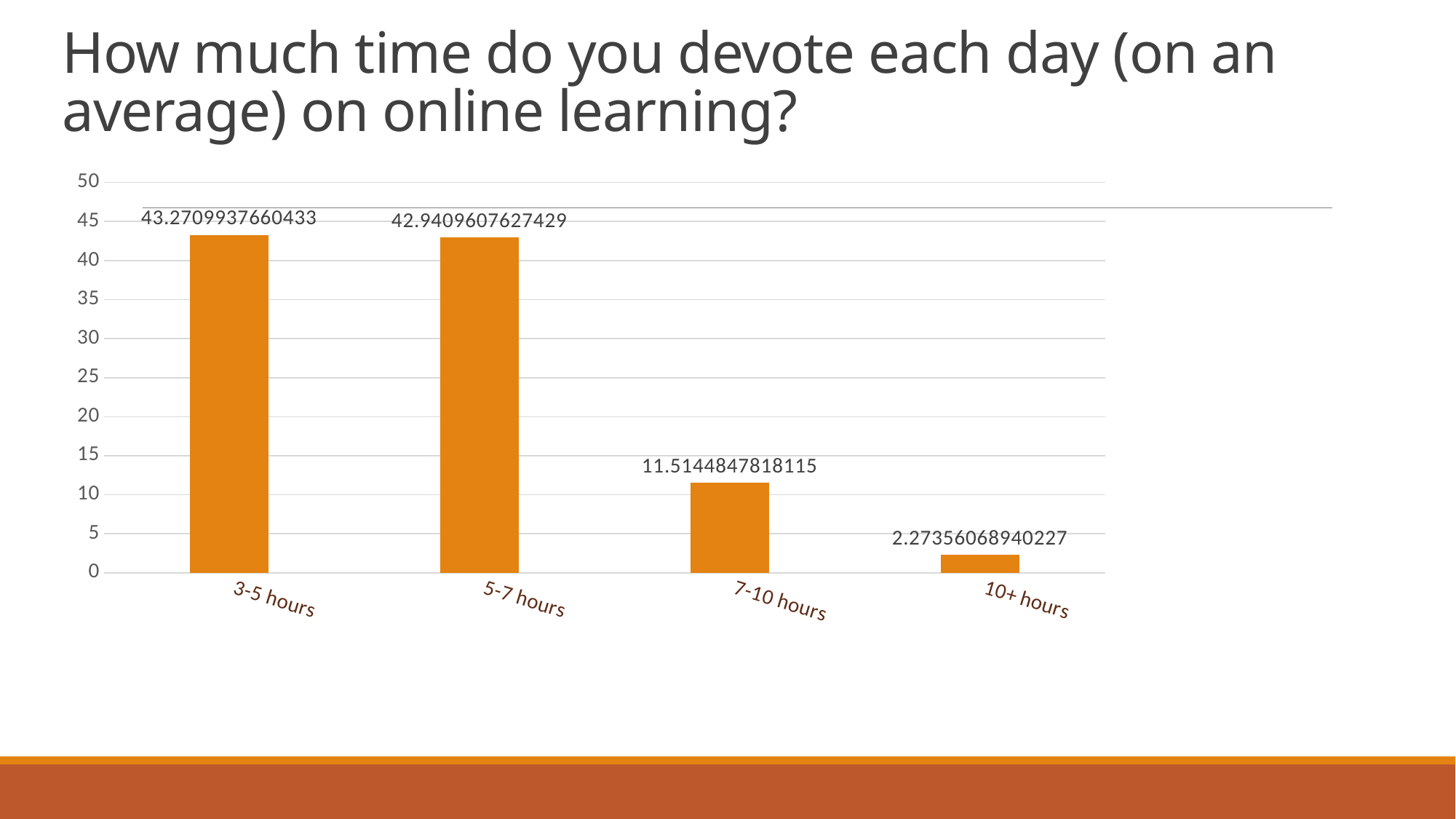
Is the value for 10+ hours greater or less than 5? less How many categories are shown on the x axis? 4 What is the value for the 3-5 hours category? 43.2709937660433 What kind of chart is shown on the slide? Bar chart Do the values rise or fall moving from left to right along the x axis? Fall Is the value for 7-10 hours greater or less than 10? greater What is the value for the 10+ hours category? 2.27356068940227 What is the value for the 5-7 hours category? 42.9409607627429 Which is larger, the value for 7-10 hours or the value for 10+ hours? 7-10 hours Which category has the lowest value? 10+ hours Which category has the highest value? 3-5 hours What is the value for the 7-10 hours category? 11.5144847818115